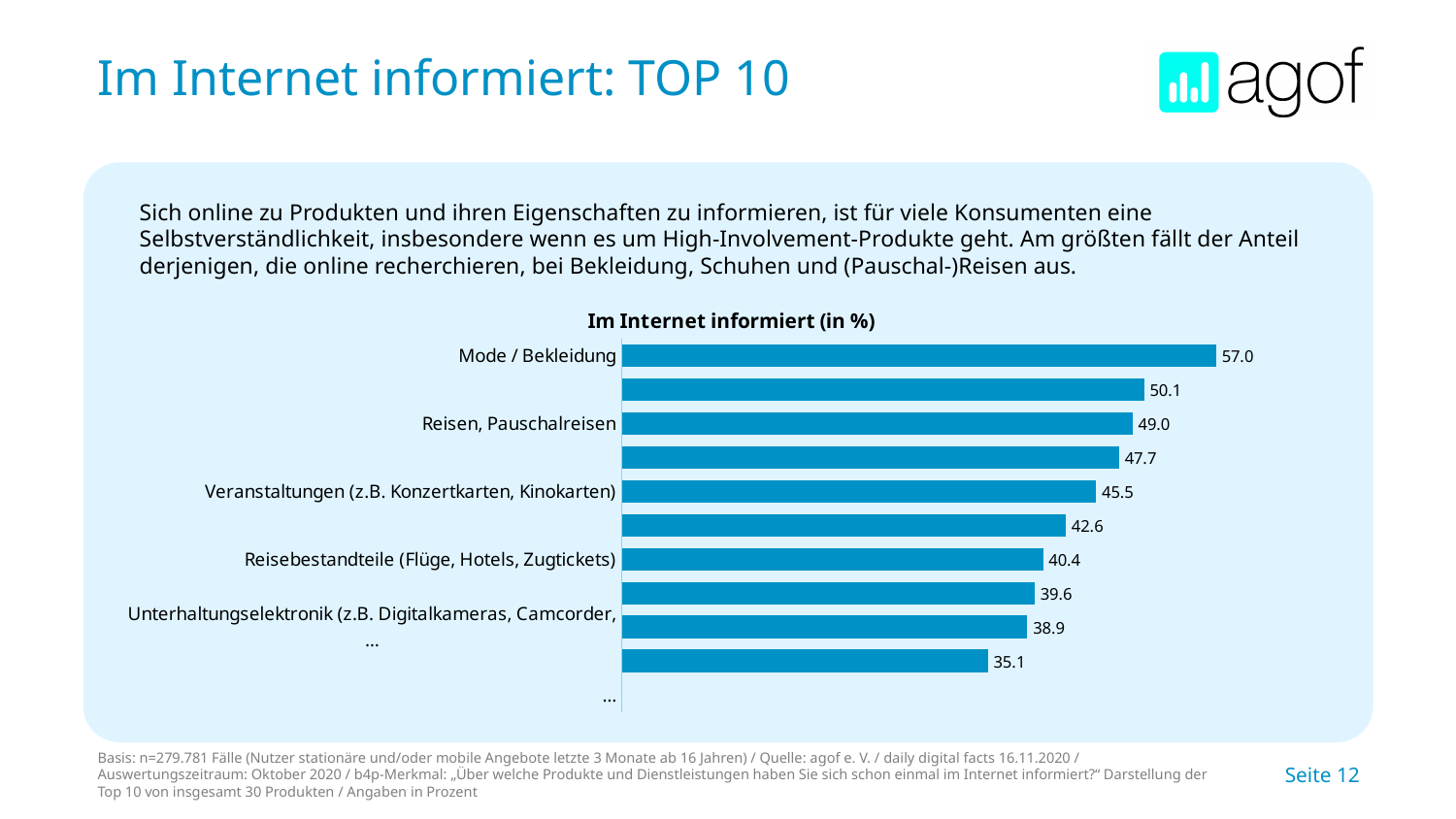
How many bars are plotted in the chart? 10 What is the value for Reisebestandteile (Flüge, Hotels, Zugtickets)? 40.4 What is the title of the chart? Im Internet informiert (in %) What is the value for Veranstaltungen (z.B. Konzertkarten, Kinokarten)? 45.5 What kind of chart is shown on the slide? Bar chart What is the difference between the values for Mode / Bekleidung and Reisen, Pauschalreisen? 8.0 What is the value for Reisen, Pauschalreisen? 49.0 Which category has the highest value in the chart? Mode / Bekleidung What is the difference between the values for Veranstaltungen (z.B. Konzertkarten, Kinokarten) and Reisebestandteile (Flüge, Hotels, Zugtickets)? 5.1 What is the value for Mode / Bekleidung? 57.0 Which is larger, the value for Reisen, Pauschalreisen or the value for Unterhaltungselektronik (z.B. Digitalkameras, Camcorder, …)? Reisen, Pauschalreisen What is the value for Unterhaltungselektronik (z.B. Digitalkameras, Camcorder, …)? 38.9